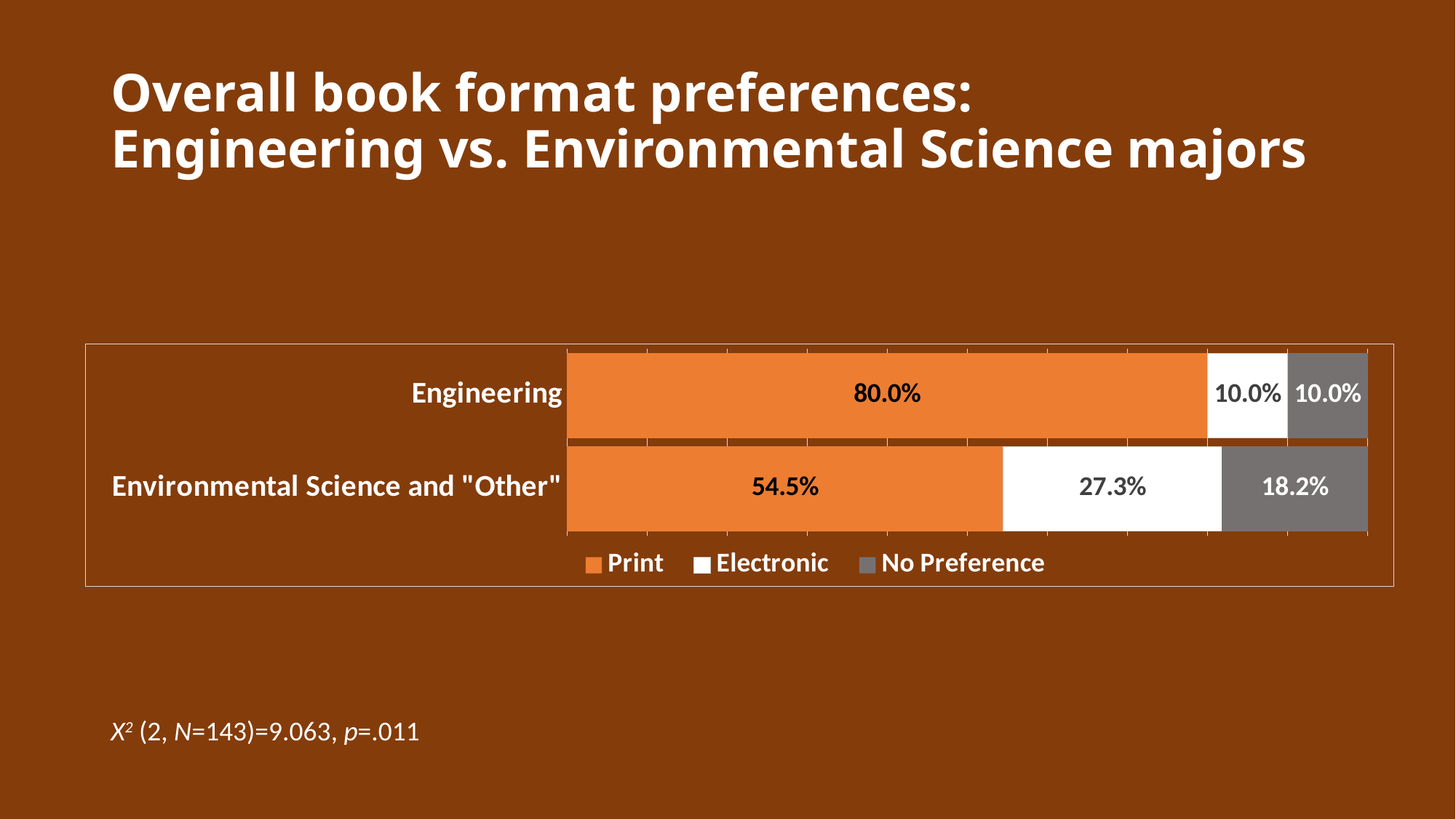
Is the No Preference value larger for Engineering or for Environmental Science and "Other"? Environmental Science and "Other" How many series does the legend list? 3 What is the difference between the Print percentages for Engineering and Environmental Science and "Other"? 25.5% What percentage of Engineering majors prefer Print? 80.0% What is the Electronic value for Engineering majors? 10.0% Which group has the lower Electronic percentage? Engineering What is the No Preference value for Environmental Science and "Other" majors? 18.2% Which colour represents the Print series in the chart? Orange Which group has the higher Print percentage? Engineering What percentage of Environmental Science and "Other" majors prefer Electronic? 27.3% How many groups (bars) are shown in the chart? 2 What kind of chart is shown on the slide? Stacked bar chart